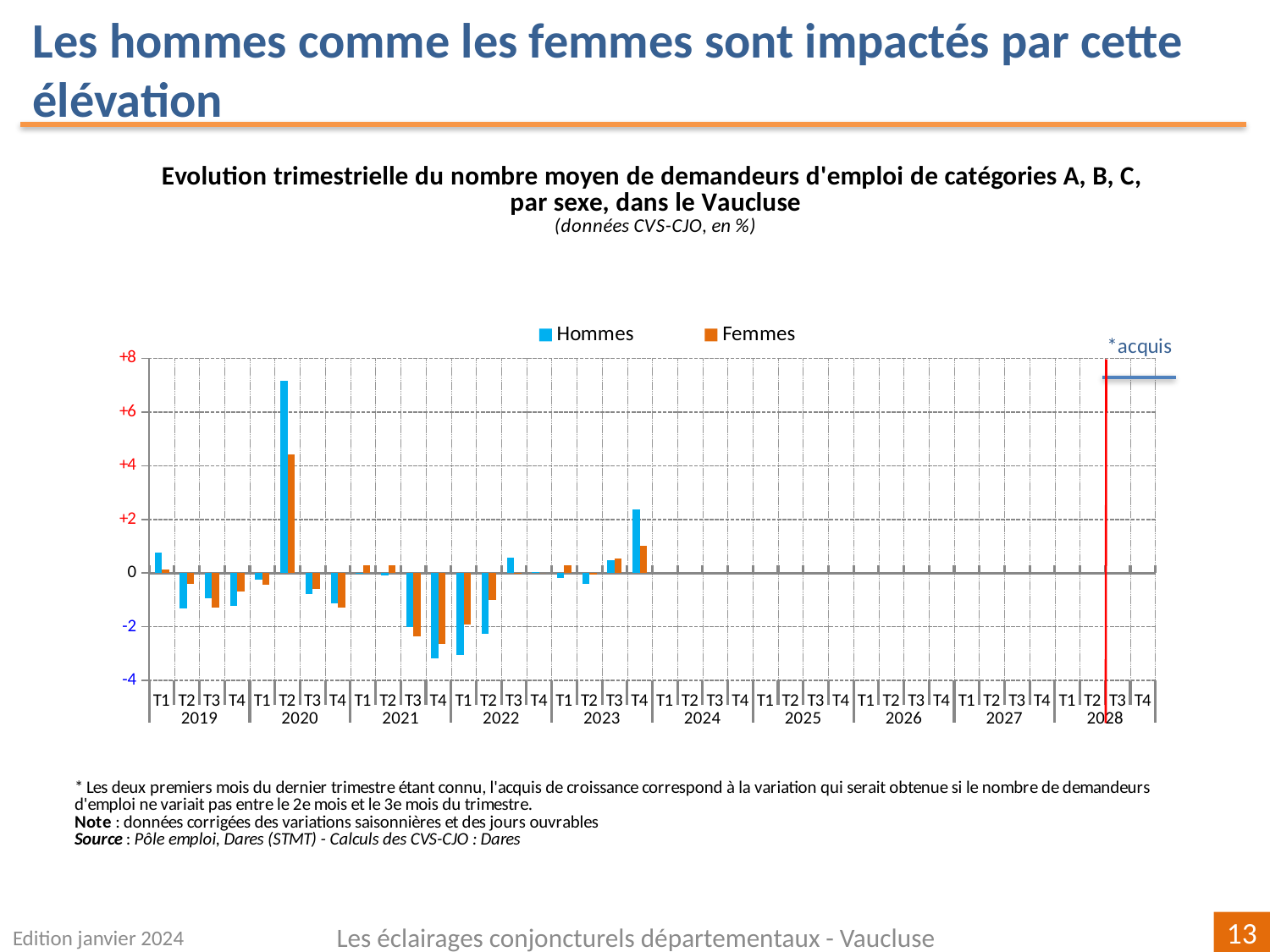
In T2 2020, which series has the larger value, Hommes or Femmes? Hommes In which quarter does the Femmes series reach its highest value? T2 2020 Is the value for Hommes in T1 2022 greater or less than -2? less Is the value for Hommes in T2 2020 greater or less than +6? greater In which quarter does the Hommes series reach its highest value? T2 2020 Is the value for Femmes in T2 2020 greater or less than +4? greater Which two series are shown in the legend? Hommes and Femmes How many series does the legend list? 2 What kind of chart is shown on the slide? bar chart In which quarter does the Femmes series reach its lowest value? T4 2021 In T4 2023, which series has the larger value, Hommes or Femmes? Hommes